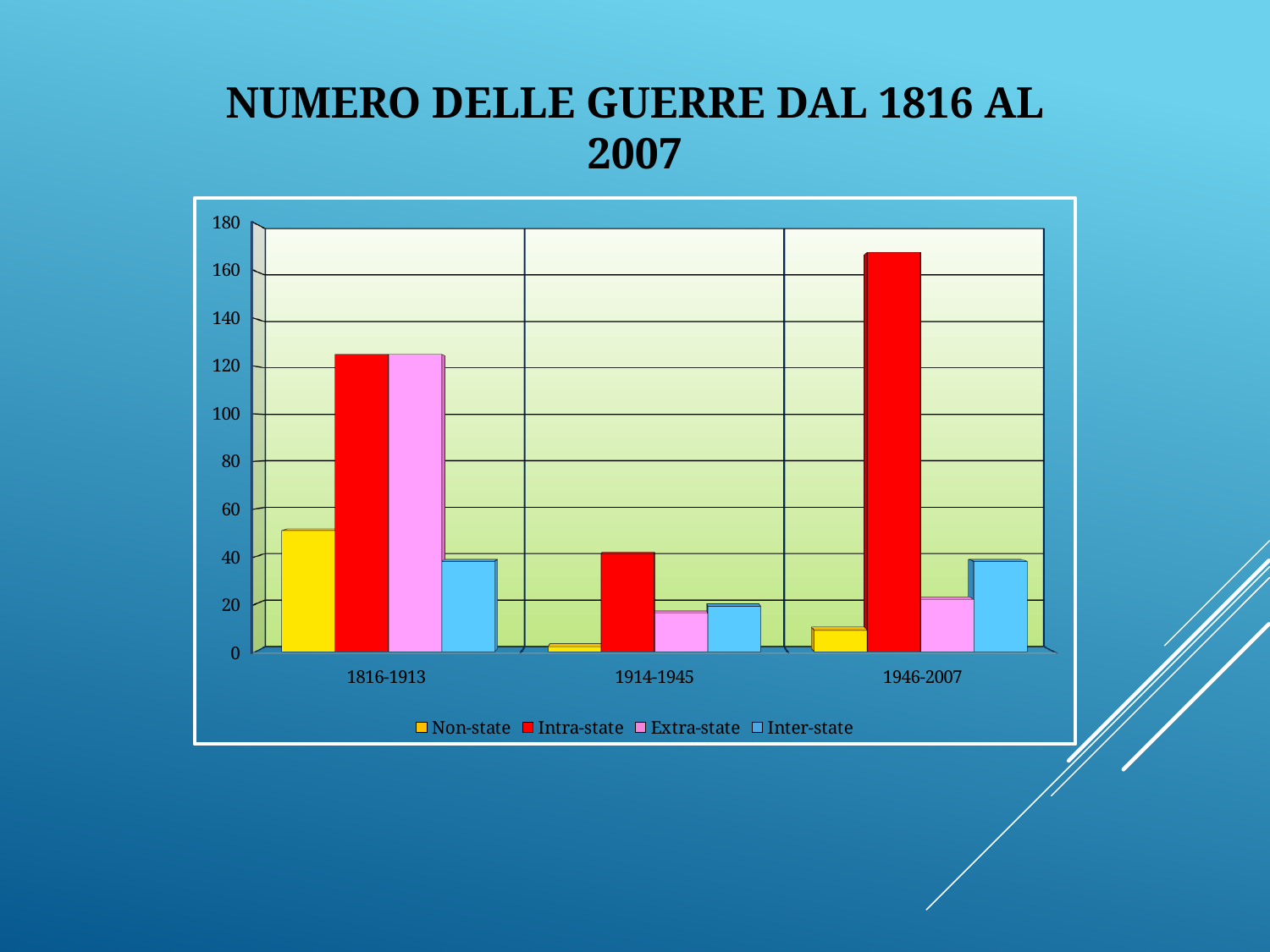
Is the Intra-state value for 1816-1913 greater or less than 100? greater How many series does the legend list? 4 Which series has the lowest value in the 1914-1945 period? Non-state In the 1816-1913 period, which is larger: Non-state or Inter-state? Non-state What kind of chart is shown on the slide? bar chart Which series has the tallest bar in the whole chart? Intra-state Is the Intra-state value for 1946-2007 greater or less than 160? greater Is the Extra-state value for 1914-1945 greater or less than 20? less In which period does Intra-state reach its highest value? 1946-2007 What is the title of the chart? NUMERO DELLE GUERRE DAL 1816 AL 2007 How many time periods are shown on the x axis? 3